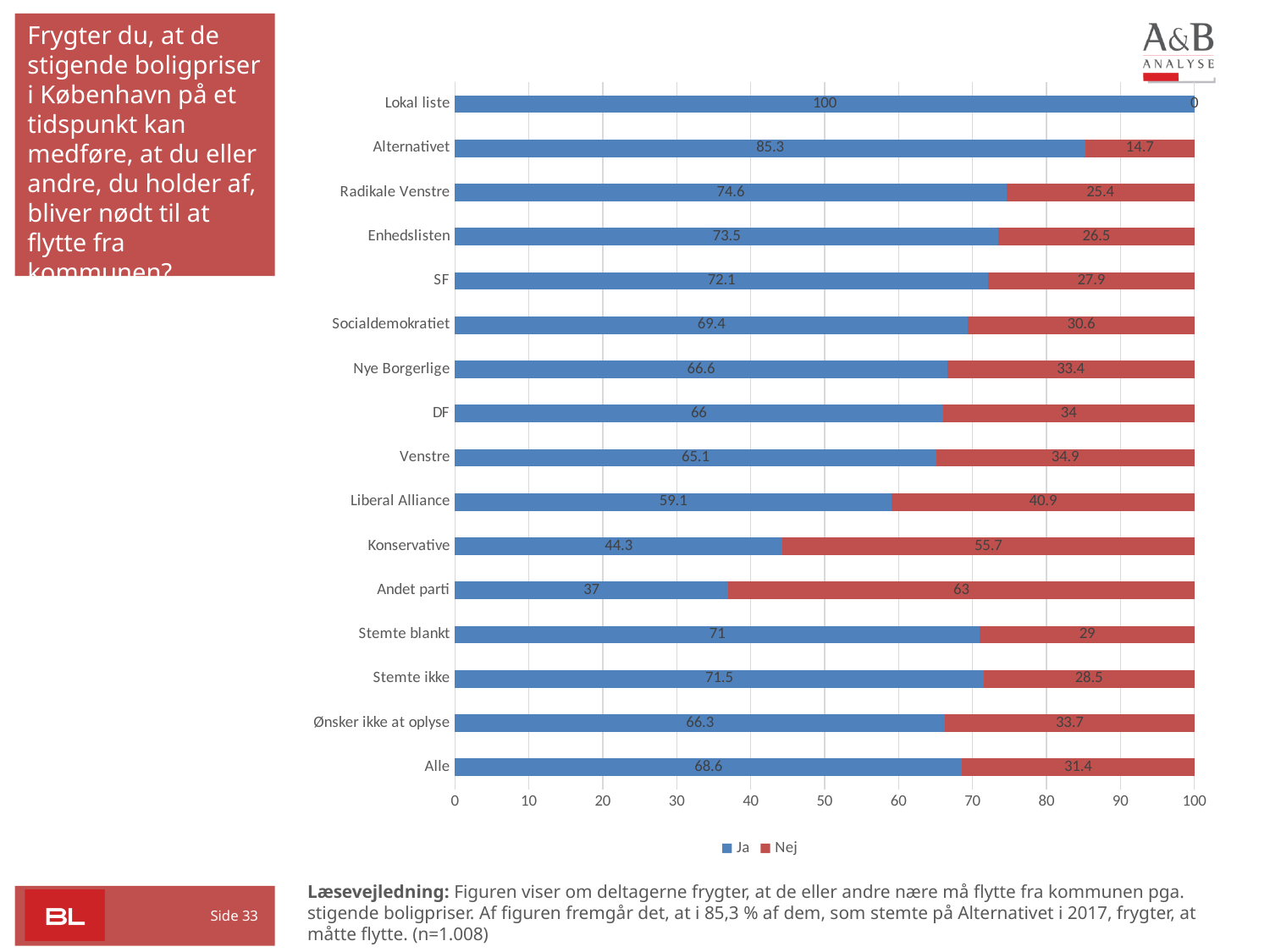
What is the total of the stacked bar for Socialdemokratiet? 100 How many categories are shown on the y axis? 16 Which series is shown in red? Nej What is the difference between the "Ja" values for Alternativet and Liberal Alliance? 26.2 Which category has the lowest "Ja" value? Andet parti How many series does the legend list? 2 Which has a larger "Nej" value, Venstre or DF? Venstre What is the "Ja" value for Alle? 68.6 What kind of chart is shown on the slide? Stacked bar chart What is the "Nej" value for Konservative? 55.7 Which category has the highest "Ja" value? Lokal liste What is the "Ja" value for Radikale Venstre? 74.6